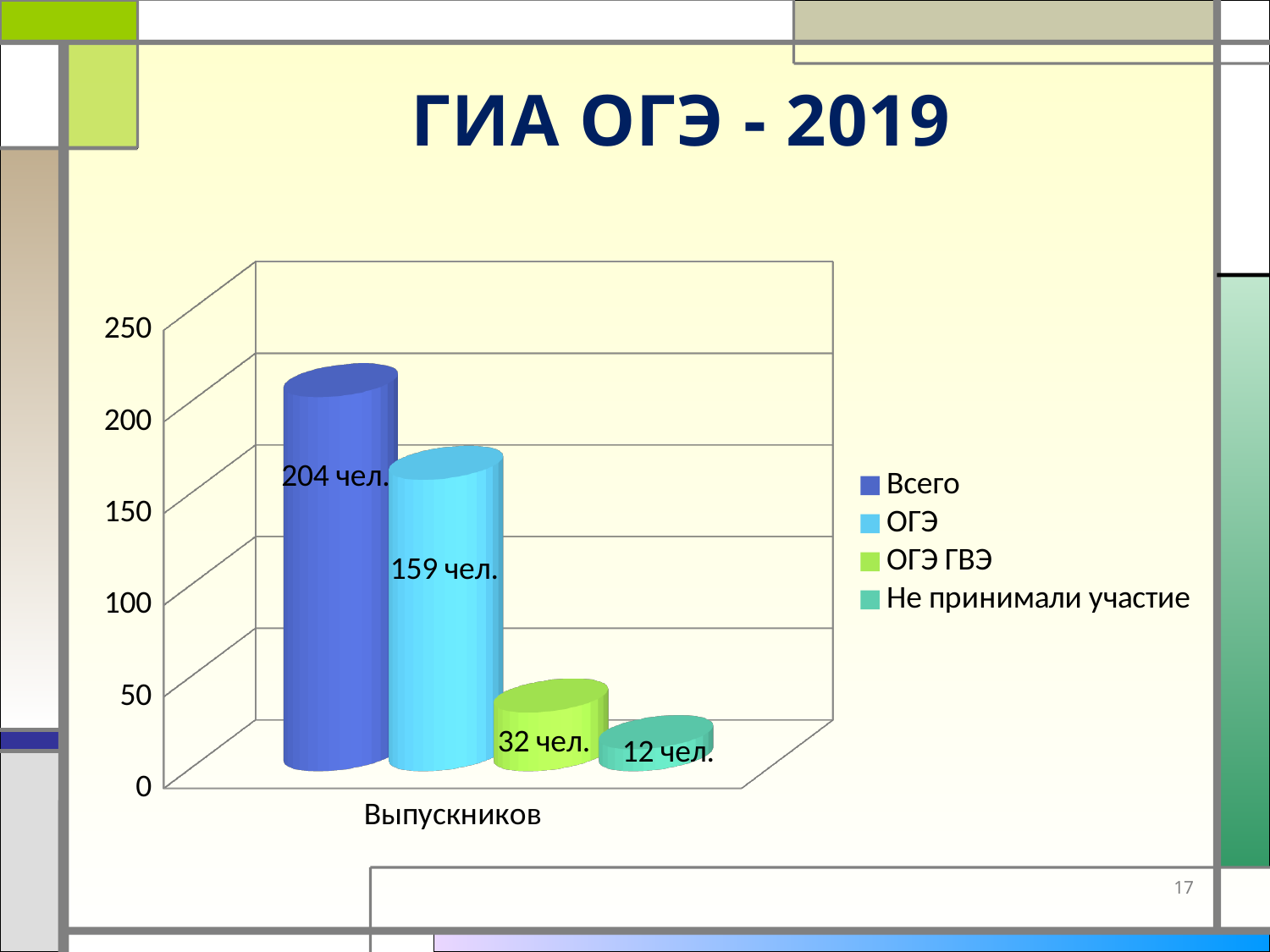
What is the difference between the 'Всего' and 'ОГЭ' values? 45 чел. What is the value for the 'ОГЭ ГВЭ' series? 32 чел. What kind of chart is shown on the slide? bar chart Which series has the lowest value? Не принимали участие What is the value for the 'ОГЭ' series? 159 чел. What is the value for the 'Всего' series? 204 чел. How many series does the legend list? 4 Which is larger, the value for 'ОГЭ ГВЭ' or for 'Не принимали участие'? ОГЭ ГВЭ What is the title of the chart? ГИА ОГЭ - 2019 Which series has the highest value? Всего What is the value for the 'Не принимали участие' series? 12 чел. Is the value for 'ОГЭ' greater or less than 150? greater